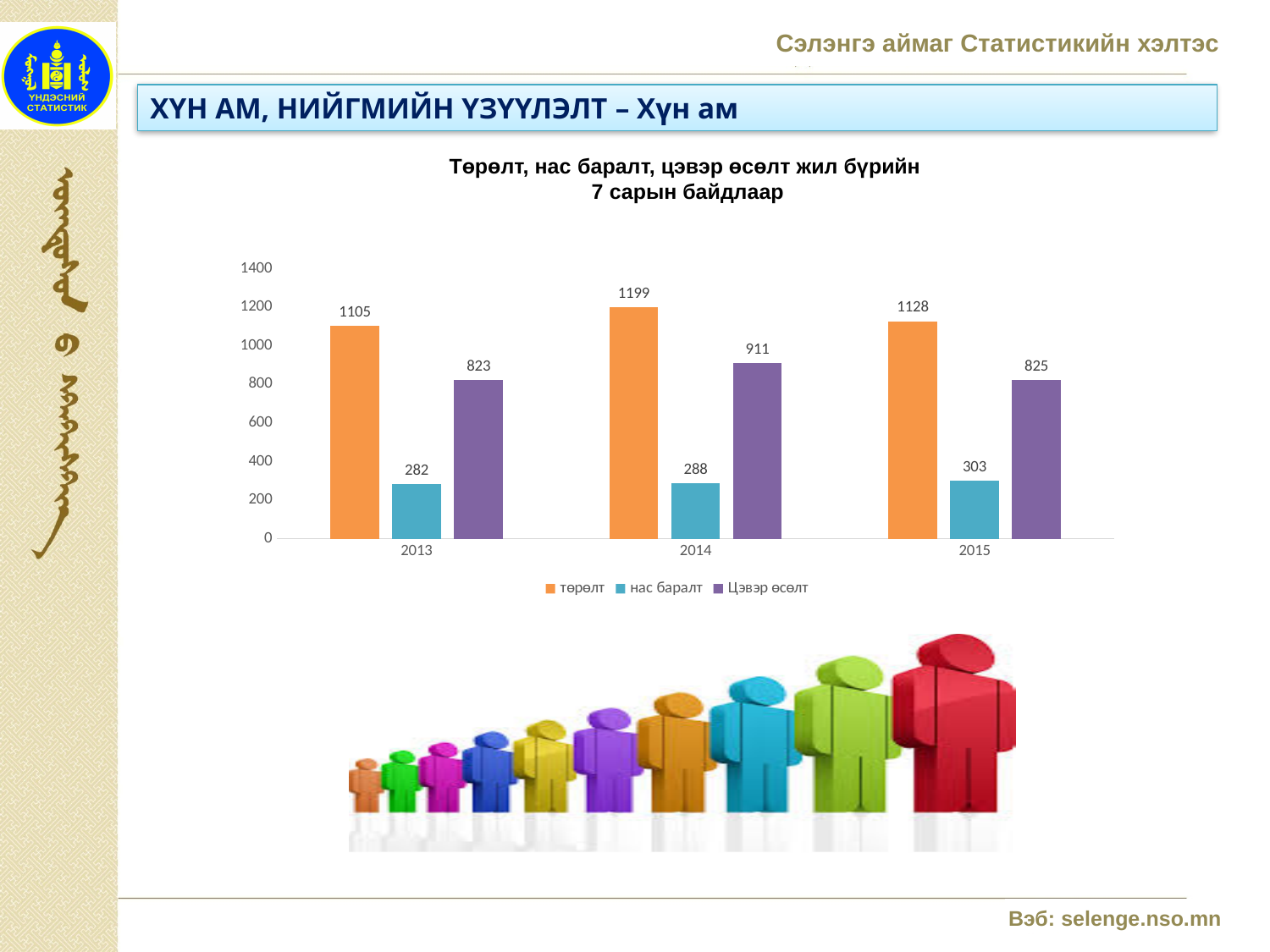
What is the difference between төрөлт and нас баралт in 2015? 825 What is the value of төрөлт for 2014? 1199 Is the value of төрөлт for 2013 greater or less than 1000? greater What is the value of нас баралт for 2015? 303 How many series does the legend list? 3 What kind of chart is shown on the slide? bar chart What is the value of Цэвэр өсөлт for 2013? 823 Which is larger: Цэвэр өсөлт in 2014 or Цэвэр өсөлт in 2015? 2014 In which year is төрөлт highest? 2014 How many years are shown on the x axis? 3 Does нас баралт rise or fall from 2013 to 2015? rise In which year is нас баралт lowest? 2013